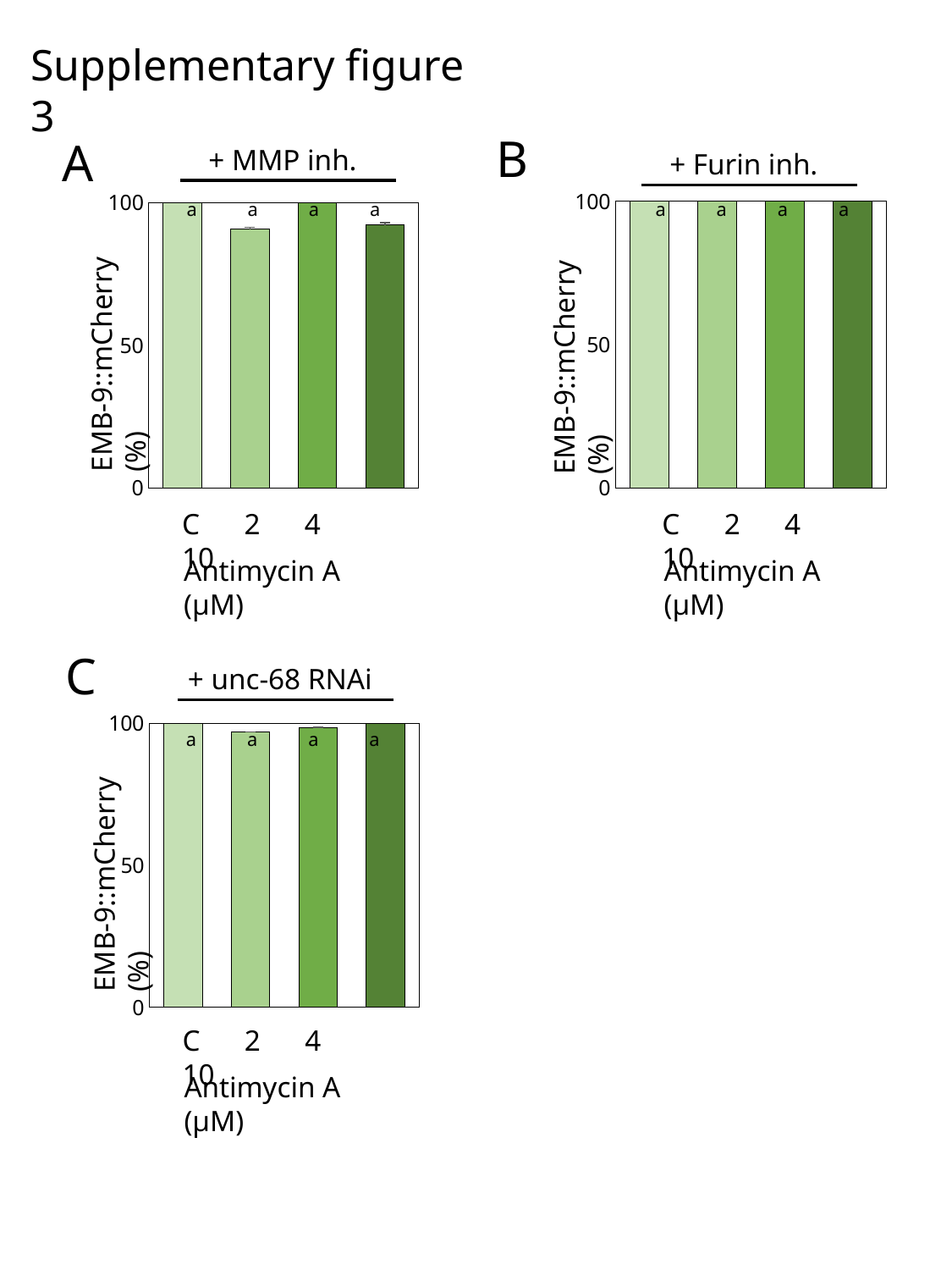
What is the y-axis label of chart A (+ MMP inh.)? EMB-9::mCherry (%) In chart A (+ MMP inh.), what is the EMB-9::mCherry (%) value for C? 100 In chart B (+ Furin inh.), is the value for 4 µM Antimycin A greater or less than 50? greater What kind of chart is chart A (+ MMP inh.)? bar chart In chart C (+ unc-68 RNAi), which is larger, the value for 10 µM Antimycin A or the value for 2 µM Antimycin A? 10 In chart A (+ MMP inh.), which Antimycin A concentration has the lowest EMB-9::mCherry (%) value? 2 In chart A (+ MMP inh.), is the value for 2 µM Antimycin A greater or less than 50? greater How many bars are plotted in chart B (+ Furin inh.)? 4 What is the title above chart C? + unc-68 RNAi In chart A (+ MMP inh.), which is larger, the value for C or the value for 2 µM Antimycin A? C In chart C (+ unc-68 RNAi), what is the EMB-9::mCherry (%) value for C? 100